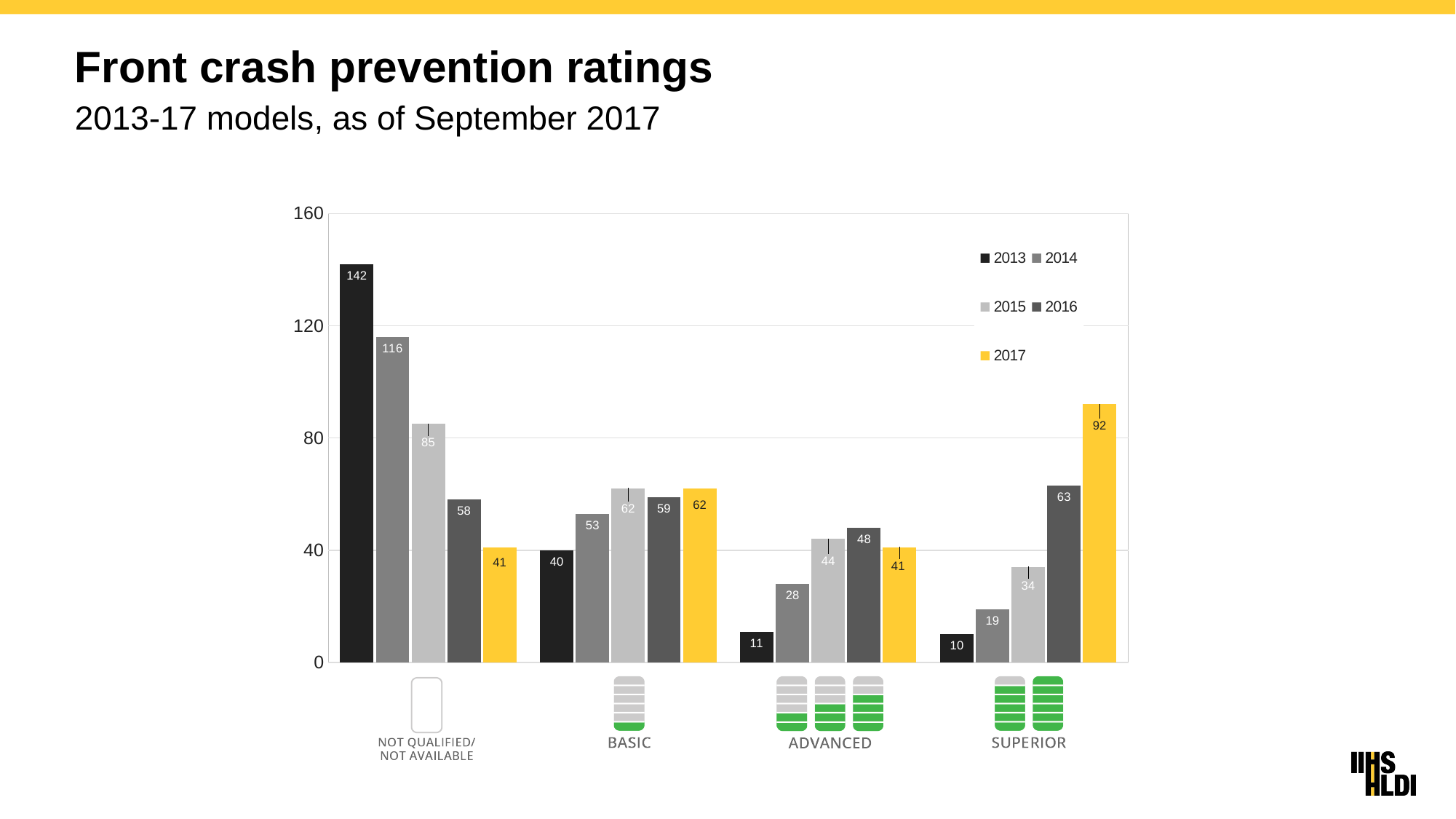
Is the value for 2014 in the Not qualified/Not available category greater or less than 120? less What kind of chart is shown on the slide? Bar chart What is the difference between the 2013 and 2014 values in the Not qualified/Not available category? 26 Which year has the lowest value in the Advanced category? 2013 What is the value for 2015 in the Advanced category? 44 How many categories are shown on the x axis? 4 What is the value for 2017 in the Superior category? 92 How many series does the legend list? 5 Which series is shown in yellow? 2017 Which is larger: the 2016 value for Basic or the 2016 value for Advanced? 2016 value for Basic What is the value for 2013 in the Not qualified/Not available category? 142 Which year has the highest value in the Superior category? 2017